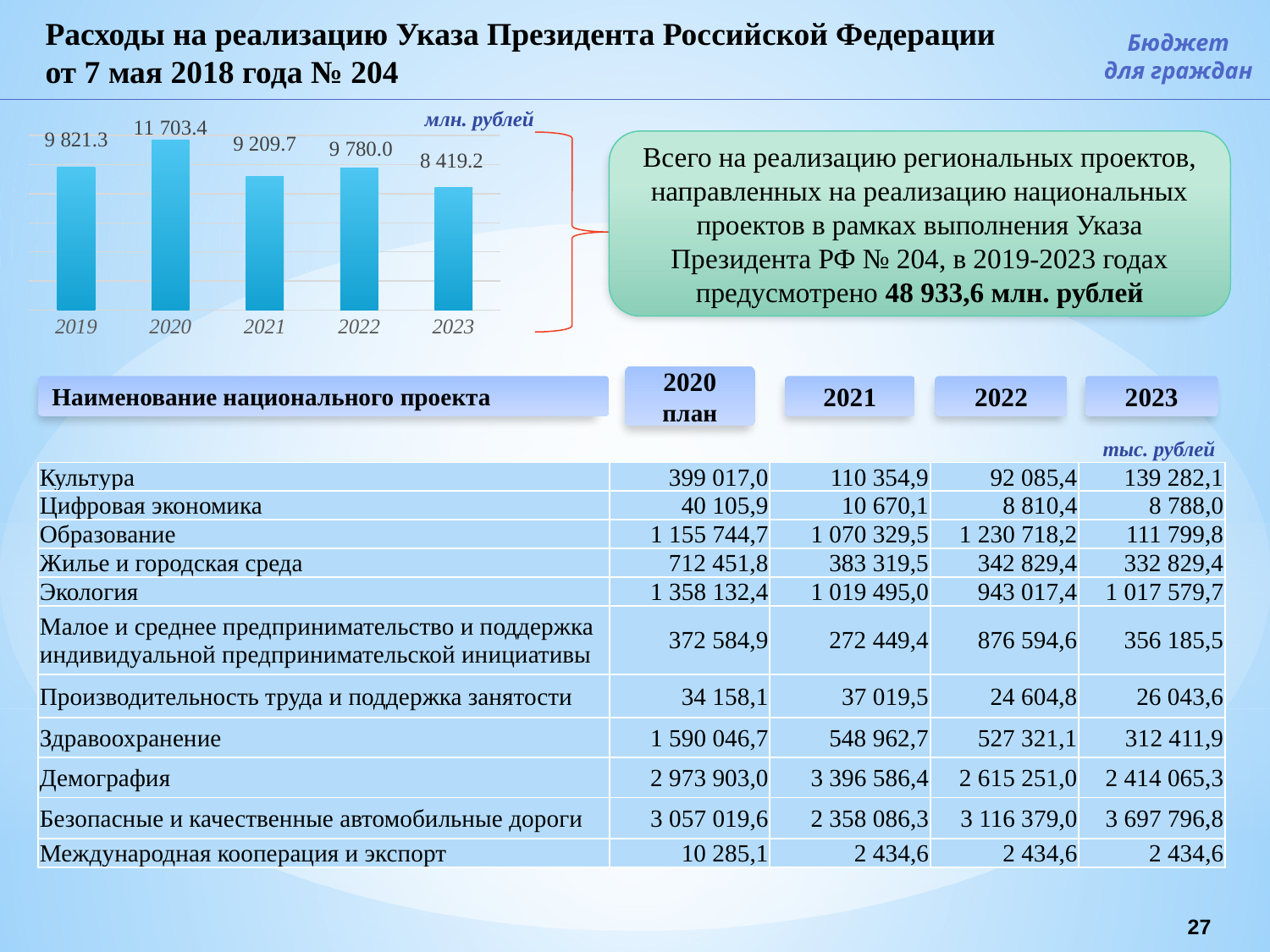
What type of chart is shown at the top left of the slide? bar chart What unit is indicated for the values in the bar chart? млн. рублей In the bar chart, what is the difference between the values for 2020 and 2019? 1 882.1 In the bar chart, what is the difference between the values for 2022 and 2023? 1 360.8 In the bar chart, which year has the lowest value? 2023 In the bar chart, what is the value for 2020? 11 703.4 How many years (bars) are shown in the bar chart? 5 In the bar chart, which year has the highest value? 2020 In the bar chart, what is the value for 2023? 8 419.2 In the bar chart, what is the value for 2019? 9 821.3 In the bar chart, does the value rise or fall from 2020 to 2021? fall In the bar chart, which is larger: the value for 2021 or the value for 2022? 2022